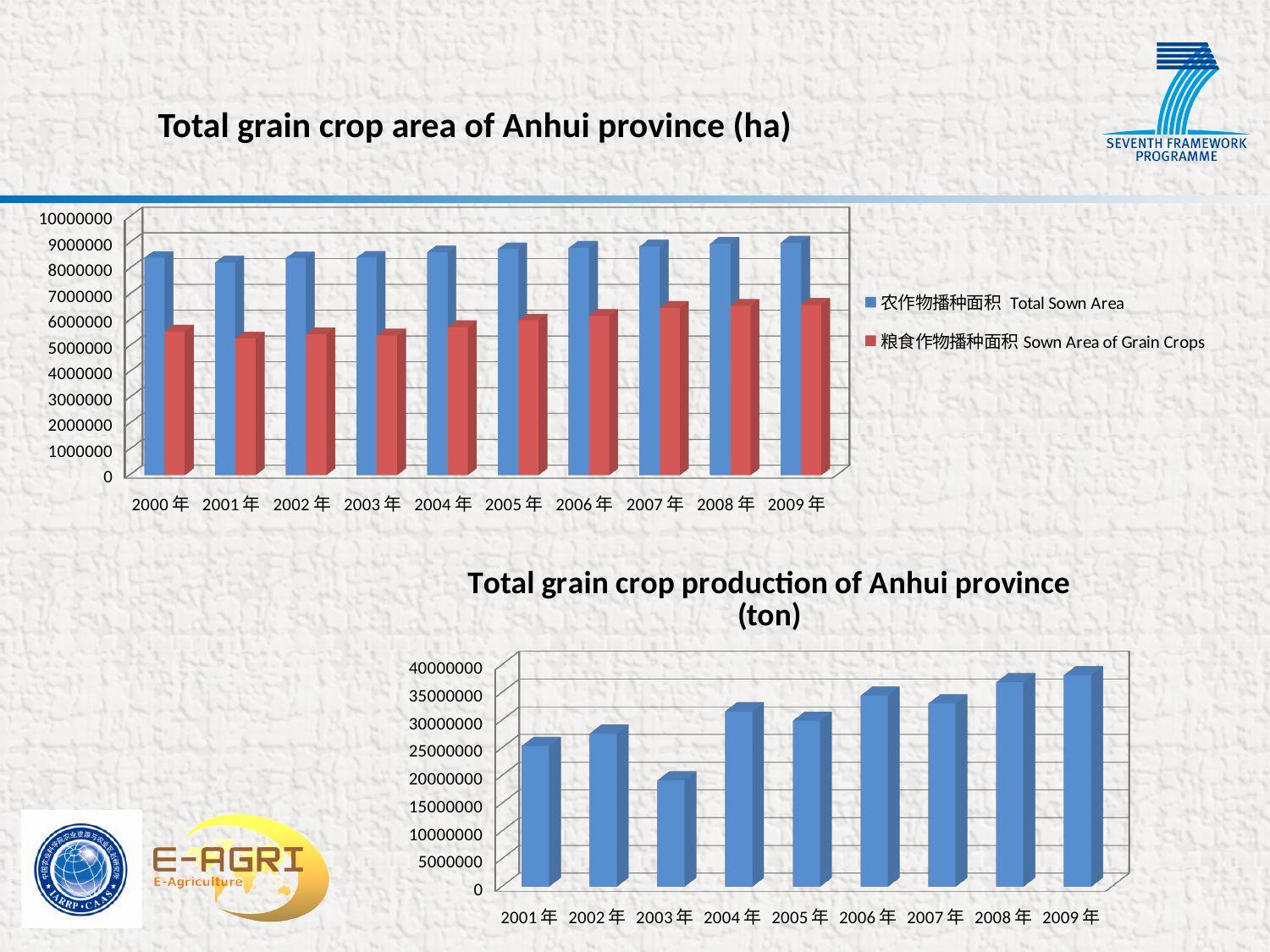
In the 'Total grain crop production of Anhui province (ton)' chart, which year has the lowest production? 2003 How many years are shown on the x axis of the 'Total grain crop production of Anhui province (ton)' chart? 9 In the 'Total grain crop area of Anhui province (ha)' chart, which series is shown in red? Sown Area of Grain Crops How many years are shown on the x axis of the 'Total grain crop area of Anhui province (ha)' chart? 10 What kind of chart is the 'Total grain crop area of Anhui province (ha)' chart? bar chart In the 'Total grain crop production of Anhui province (ton)' chart, is the value for 2006 greater or less than 30000000? greater What kind of chart is the 'Total grain crop production of Anhui province (ton)' chart? bar chart In the 'Total grain crop area of Anhui province (ha)' chart, is the Total Sown Area for 2000 greater or less than 8000000? greater In the 'Total grain crop area of Anhui province (ha)' chart, which year has the lowest Total Sown Area? 2001 In the 'Total grain crop area of Anhui province (ha)' chart, is the Sown Area of Grain Crops for 2009 greater or less than 6000000? greater In the 'Total grain crop production of Anhui province (ton)' chart, which year has the highest production? 2009 How many series does the legend of the 'Total grain crop area of Anhui province (ha)' chart list? 2